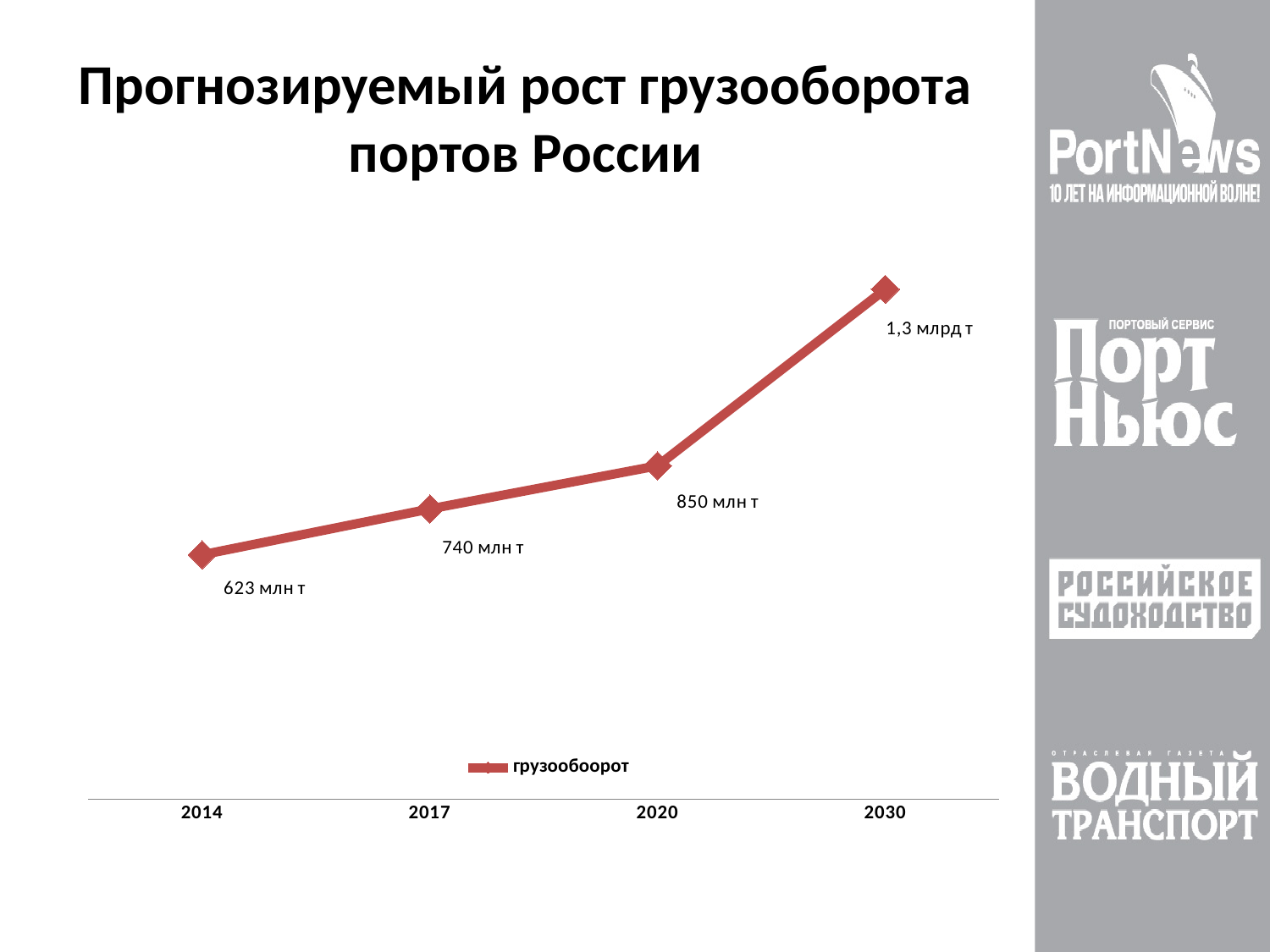
Which is larger, the value for 2020 or the value for 2017? 2020 What is the difference between the 2020 and 2017 values? 110 млн т How many data points are plotted on the chart? 4 What is the difference between the 2017 and 2014 values? 117 млн т What kind of chart is shown on the slide? Line chart What is the cargo turnover value shown for 2030? 1,3 млрд т Do the values rise or fall from 2014 to 2030? Rise Which year has the highest cargo turnover value? 2030 Which year has the lowest cargo turnover value? 2014 What is the cargo turnover value shown for 2017? 740 млн т What is the cargo turnover value shown for 2020? 850 млн т What is the cargo turnover value shown for 2014? 623 млн т